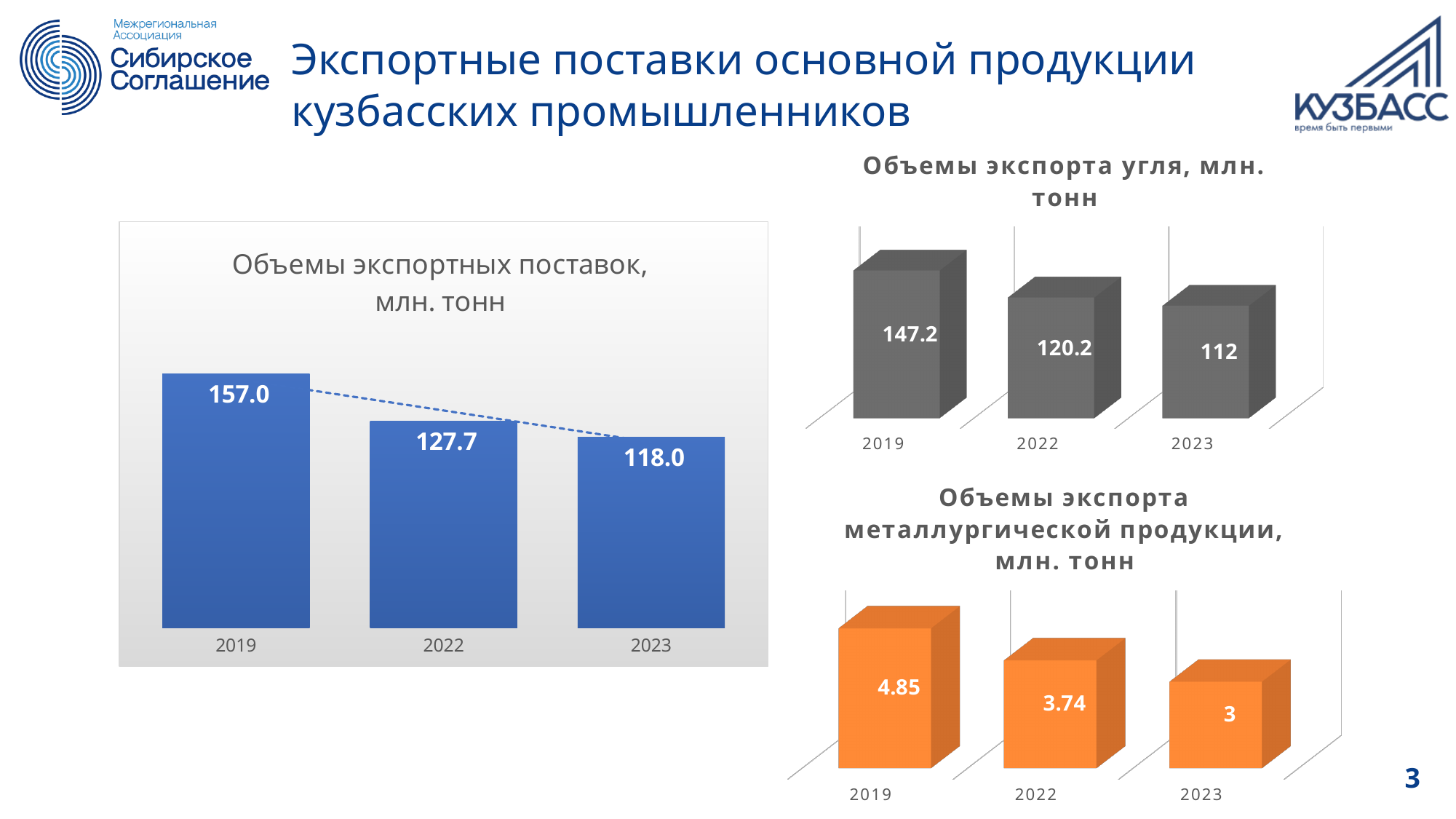
In the chart titled "Объемы экспорта угля, млн. тонн", which year has the highest value? 2019 In the chart titled "Объемы экспорта металлургической продукции, млн. тонн", which year has the lowest value? 2023 In the chart titled "Объемы экспортных поставок, млн. тонн", what is the value for 2019? 157.0 What kind of chart is the chart titled "Объемы экспорта металлургической продукции, млн. тонн"? bar chart In the chart titled "Объемы экспорта металлургической продукции, млн. тонн", which is larger, the value for 2022 or the value for 2023? 2022 In the chart titled "Объемы экспортных поставок, млн. тонн", do the values rise or fall from 2019 to 2023? fall In the chart titled "Объемы экспортных поставок, млн. тонн", what is the value for 2023? 118.0 In the chart titled "Объемы экспорта угля, млн. тонн", what is the difference between the 2019 and 2023 values? 35.2 In the chart titled "Объемы экспорта металлургической продукции, млн. тонн", what is the value for 2019? 4.85 In the chart titled "Объемы экспортных поставок, млн. тонн", what is the difference between the 2019 and 2022 values? 29.3 In the chart titled "Объемы экспорта угля, млн. тонн", how many years are shown? 3 In the chart titled "Объемы экспорта угля, млн. тонн", what is the value for 2022? 120.2